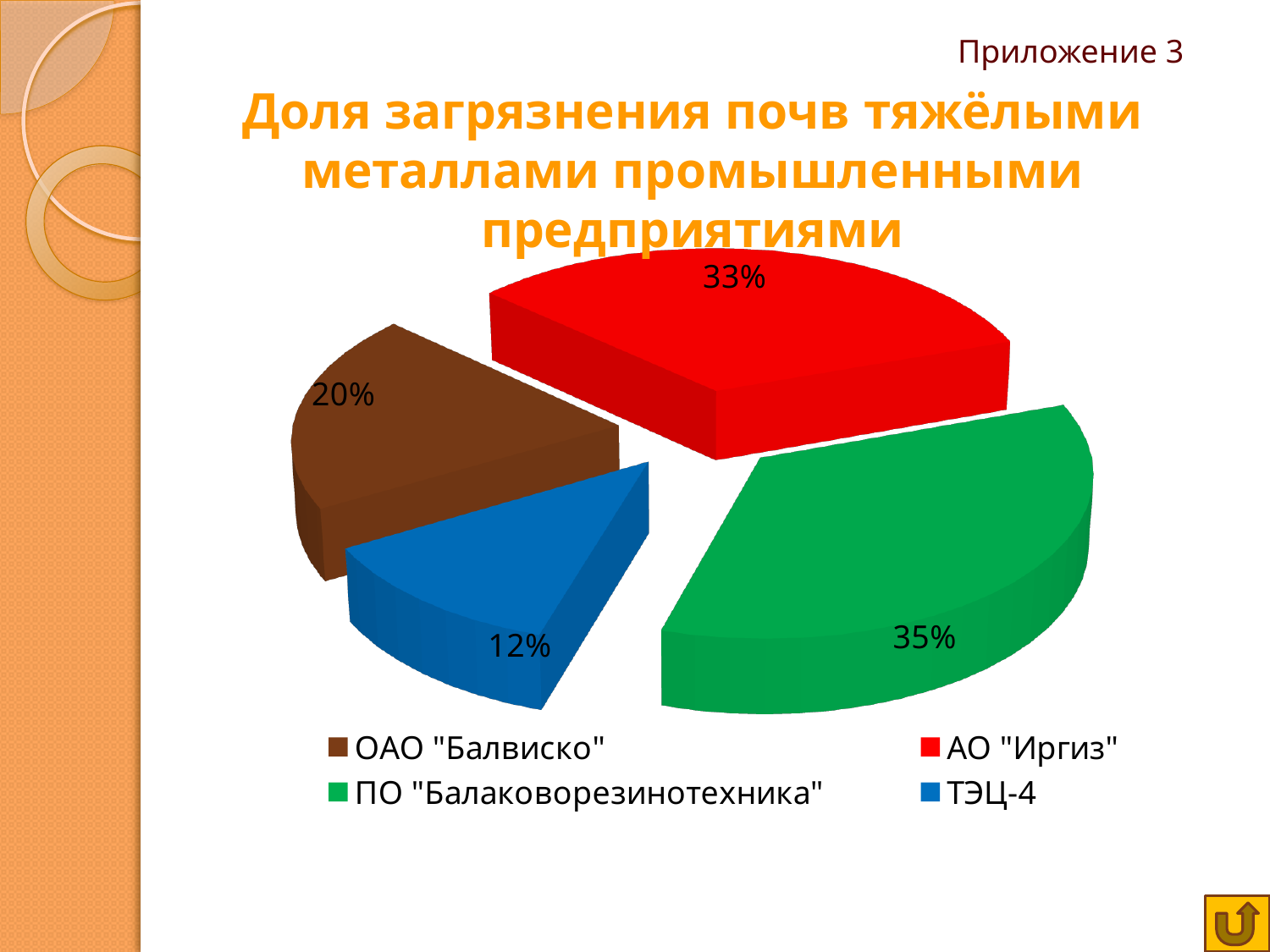
What kind of chart is shown on the slide? Pie chart What share of the pie does ТЭЦ-4 have? 12% What colour is the slice for ТЭЦ-4? Blue How many slices does the pie chart have? 4 What is the difference in percentage points between the shares of ОАО "Балвиско" and ТЭЦ-4? 8 What share of the pie does ОАО "Балвиско" have? 20% Which enterprise has the smallest share of the pie? ТЭЦ-4 Which enterprise is represented by the red slice? АО "Иргиз" What share of the pie does АО "Иргиз" have? 33% Which has a larger share, АО "Иргиз" or ОАО "Балвиско"? АО "Иргиз" Which enterprise has the largest share of the pie? ПО "Балаковорезинотехника" What share of the pie does ПО "Балаковорезинотехника" have? 35%